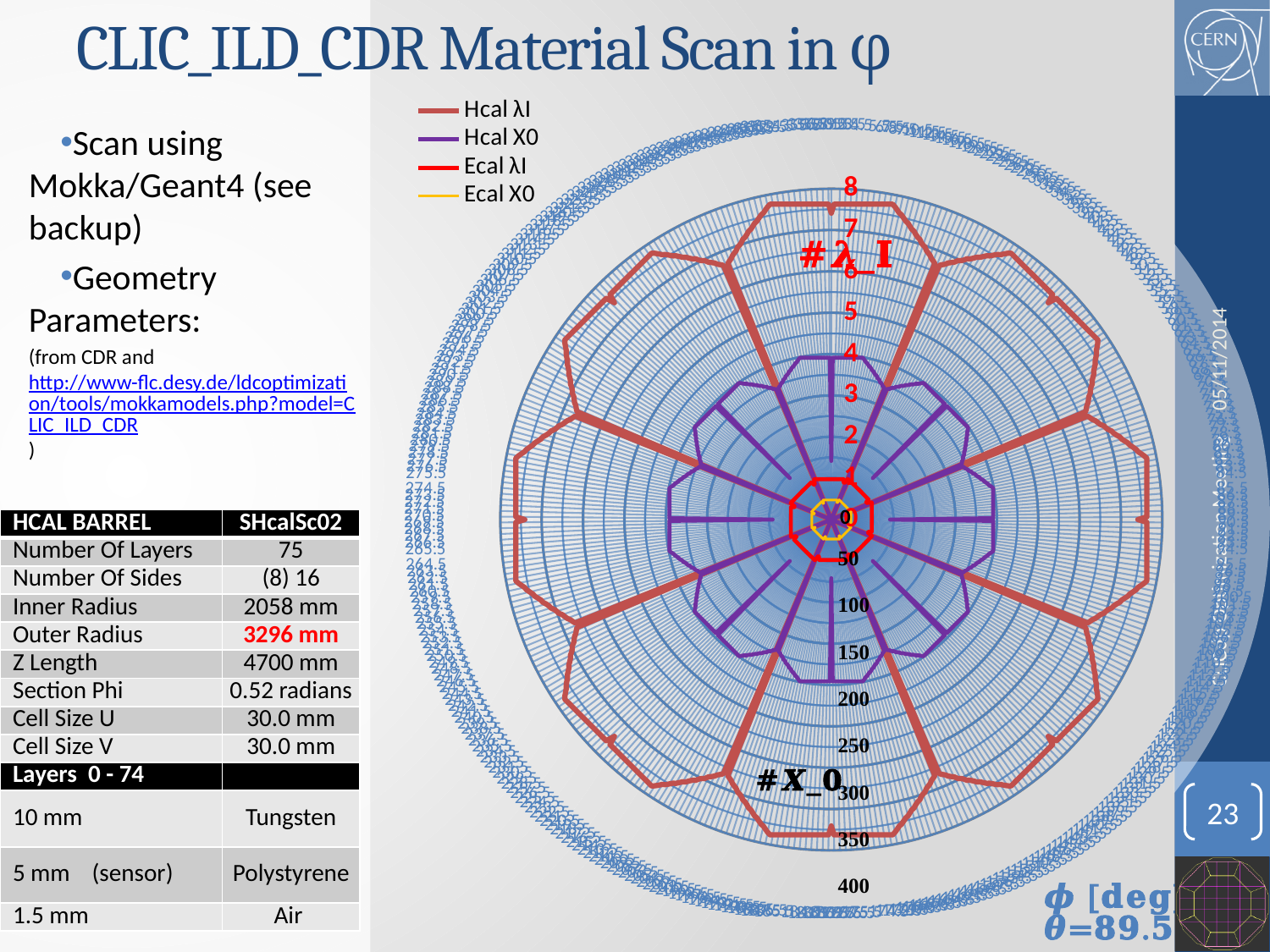
Is the value of Ecal λI greater or less than 2 on the λ_I scale? less Is the value of Hcal X0 greater or less than 100 on the X_0 scale? greater What kind of chart is shown on the slide? radar chart Which series extends furthest from the centre of the chart? Hcal λI Is the value of Hcal λI greater or less than 5 on the λ_I scale? greater Which series is drawn in yellow in the chart? Ecal X0 How many series does the chart legend list? 4 Which series stays closest to the centre of the chart? Ecal X0 Which series is drawn in purple in the chart? Hcal X0 Which series has larger values, Hcal λI or Ecal λI? Hcal λI Which series has larger values, Hcal X0 or Ecal X0? Hcal X0